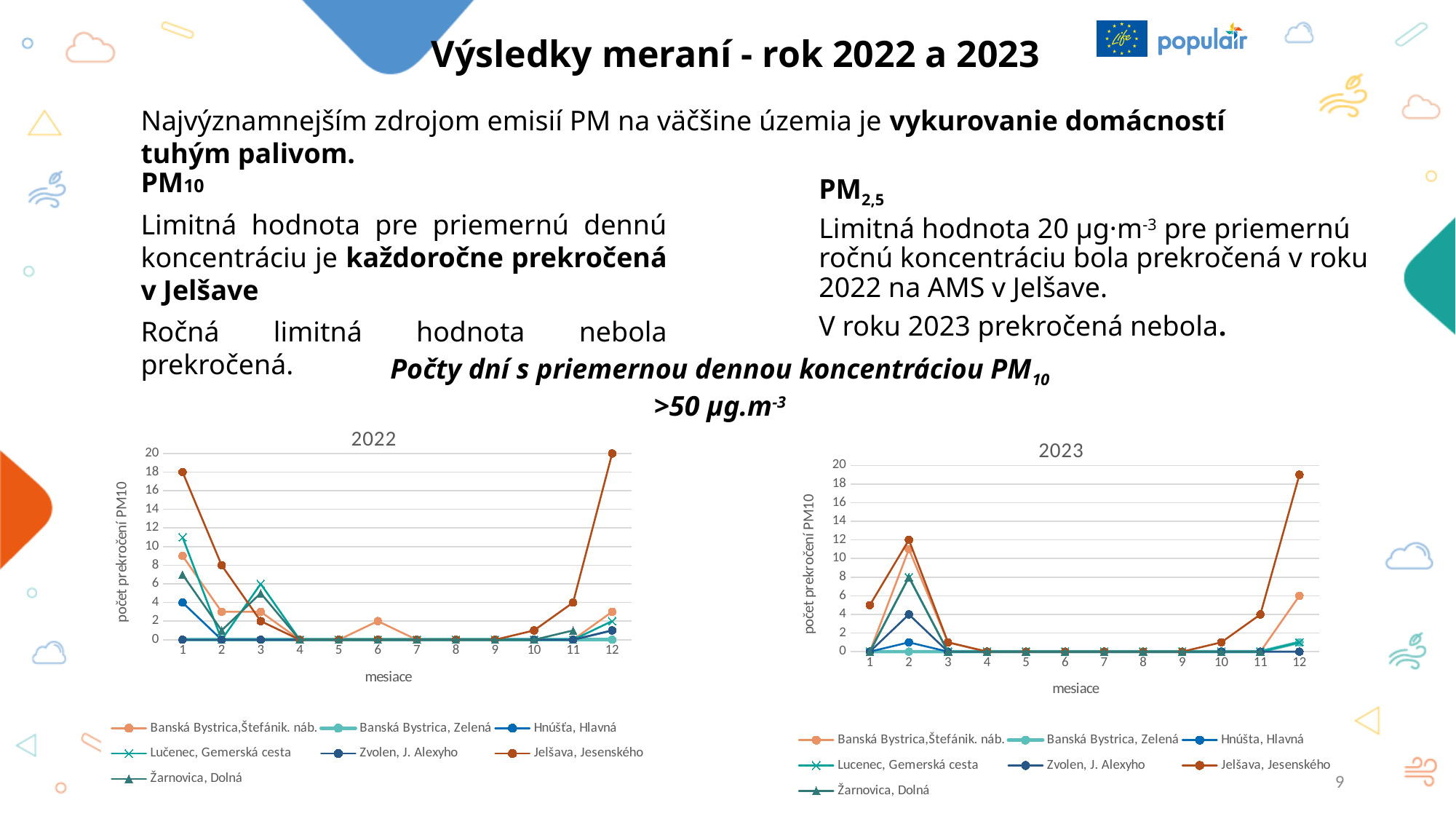
In the 2023 chart, what is the value for Jelšava, Jesenského in month 2? 12 In the 2022 chart, how many series does the legend list? 7 In the 2022 chart, how many months are shown on the x axis? 12 What kind of chart is the 2022 chart? line chart In the 2023 chart, which series has the highest value in month 12? Jelšava, Jesenského In the 2022 chart, which series has the highest value in month 12? Jelšava, Jesenského In the 2022 chart, what is the value for Hnúšťa, Hlavná in month 1? 4 In the 2023 chart, what is the label of the y axis? počet prekročení PM10 In the 2022 chart, is the value for Banská Bystrica, Štefánik. náb. in month 1 greater or less than 8? greater In the 2022 chart, what is the value for Jelšava, Jesenského in month 1? 18 In the 2023 chart, is the value for Jelšava, Jesenského in month 12 greater or less than 18? greater In the 2022 chart, what is the value for Jelšava, Jesenského in month 12? 20